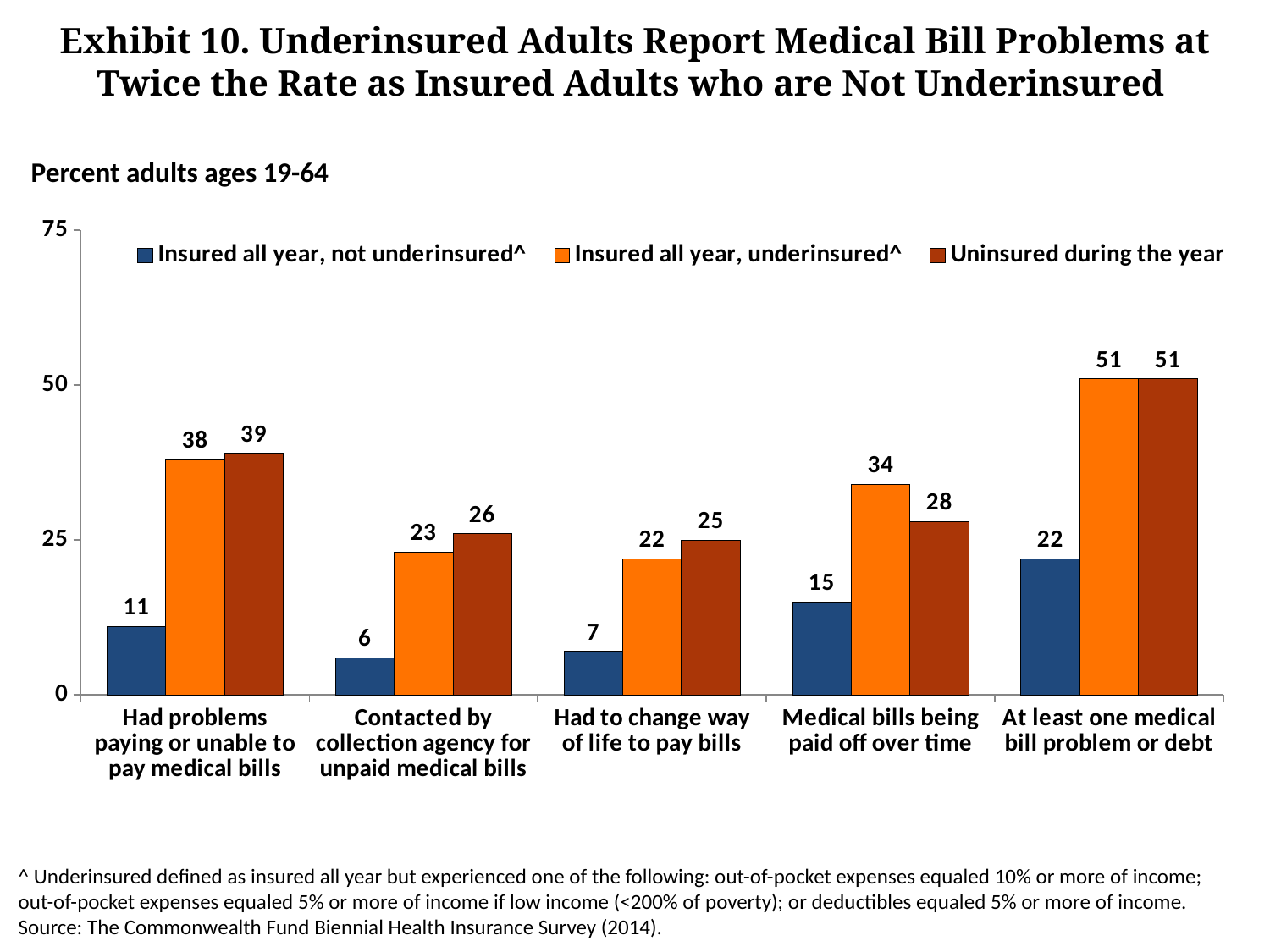
How many categories are shown on the x axis? 5 What is the difference between the "Insured all year, underinsured^" and "Insured all year, not underinsured^" values in the "Medical bills being paid off over time" category? 19 Which category has the highest value for the "Insured all year, not underinsured^" series? At least one medical bill problem or debt What is the axis label shown above the chart? Percent adults ages 19-64 What kind of chart is shown on the slide? Bar chart What is the value for "Insured all year, not underinsured^" in the "Contacted by collection agency for unpaid medical bills" category? 6 How many series does the legend list? 3 What is the value for "Insured all year, underinsured^" in the "Had problems paying or unable to pay medical bills" category? 38 Which category has the lowest value for the "Uninsured during the year" series? Had to change way of life to pay bills What is the value for "Uninsured during the year" in the "Medical bills being paid off over time" category? 28 What is the value for "Uninsured during the year" in the "At least one medical bill problem or debt" category? 51 In the "Had to change way of life to pay bills" category, which is larger: the value for "Insured all year, underinsured^" or "Uninsured during the year"? Uninsured during the year